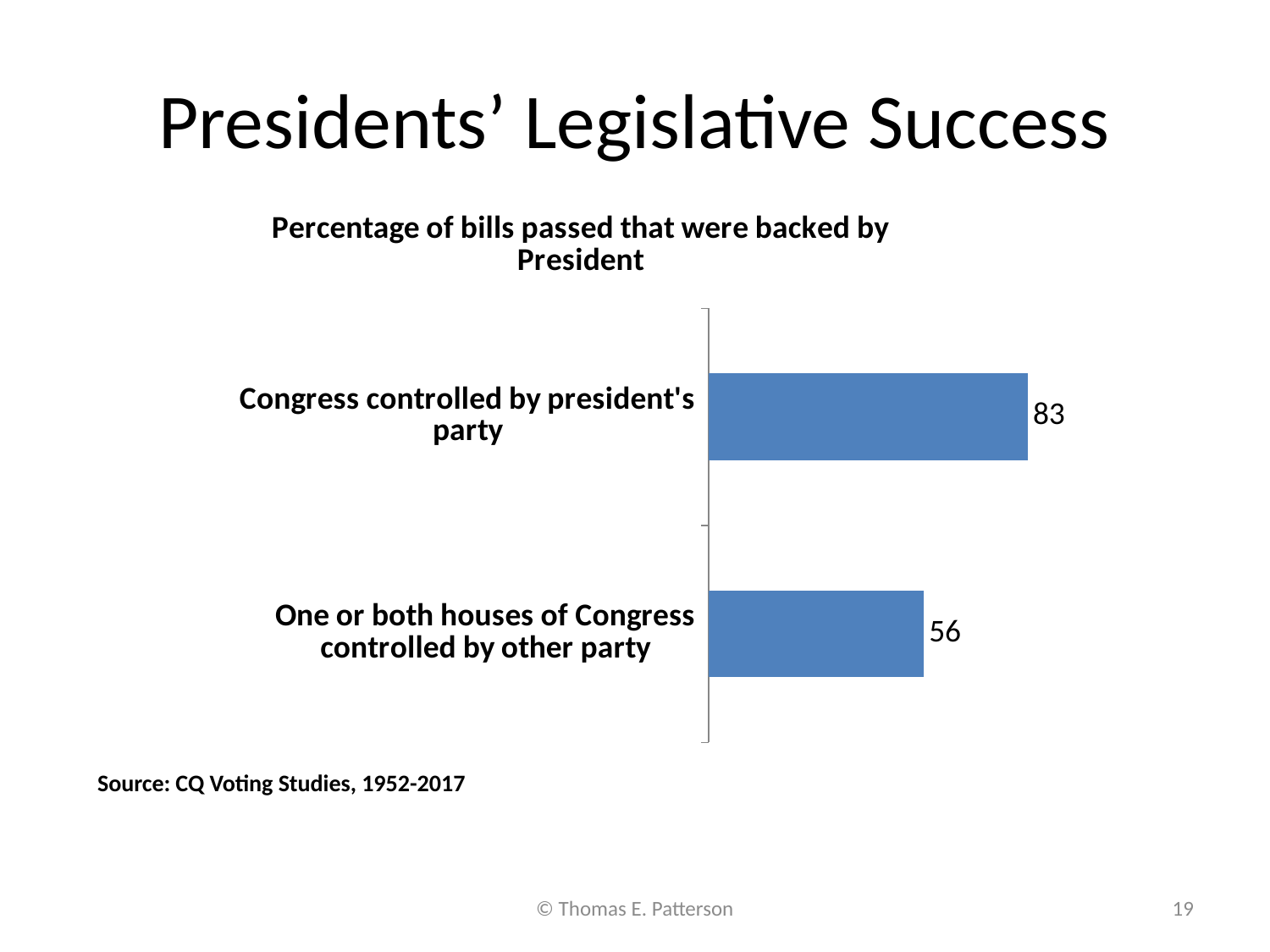
What is the value for 'Congress controlled by president's party'? 83 Which category has the lowest value? One or both houses of Congress controlled by other party What is the difference between the value for 'Congress controlled by president's party' and the value for 'One or both houses of Congress controlled by other party'? 27 What kind of chart is shown on the slide? Bar chart How many categories are shown in the chart? 2 Which category has the highest value? Congress controlled by president's party Which is larger: the value for 'Congress controlled by president's party' or the value for 'One or both houses of Congress controlled by other party'? Congress controlled by president's party What is the value for 'One or both houses of Congress controlled by other party'? 56 What is the title of the chart? Percentage of bills passed that were backed by President What source is cited for the chart data? CQ Voting Studies, 1952-2017